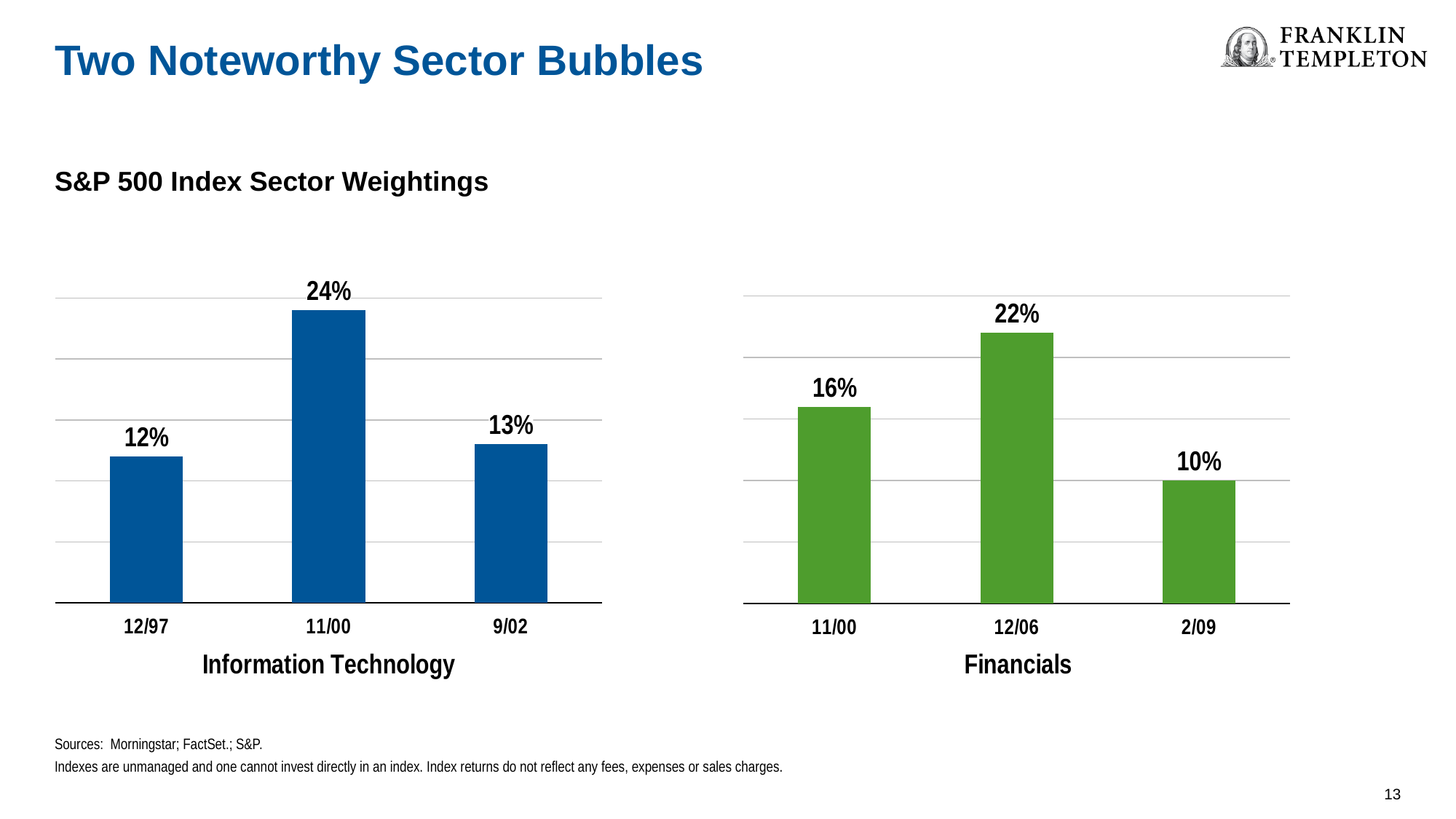
In the Information Technology chart, what is the difference between the values for 11/00 and 12/97? 12% In the Information Technology chart, what is the value for 11/00? 24% What kind of chart is the Financials chart? Bar chart In the Financials chart, what is the difference between the values for 12/06 and 2/09? 12% What colour are the bars in the Financials chart? Green In the Information Technology chart, what is the value for 12/97? 12% In the Financials chart, what is the value for 2/09? 10% In the Information Technology chart, which date has the highest value? 11/00 In the Financials chart, which date has the lowest value? 2/09 In the Financials chart, which is larger, the value for 11/00 or the value for 2/09? 11/00 In the Financials chart, what is the value for 12/06? 22% How many bars are in the Information Technology chart? 3